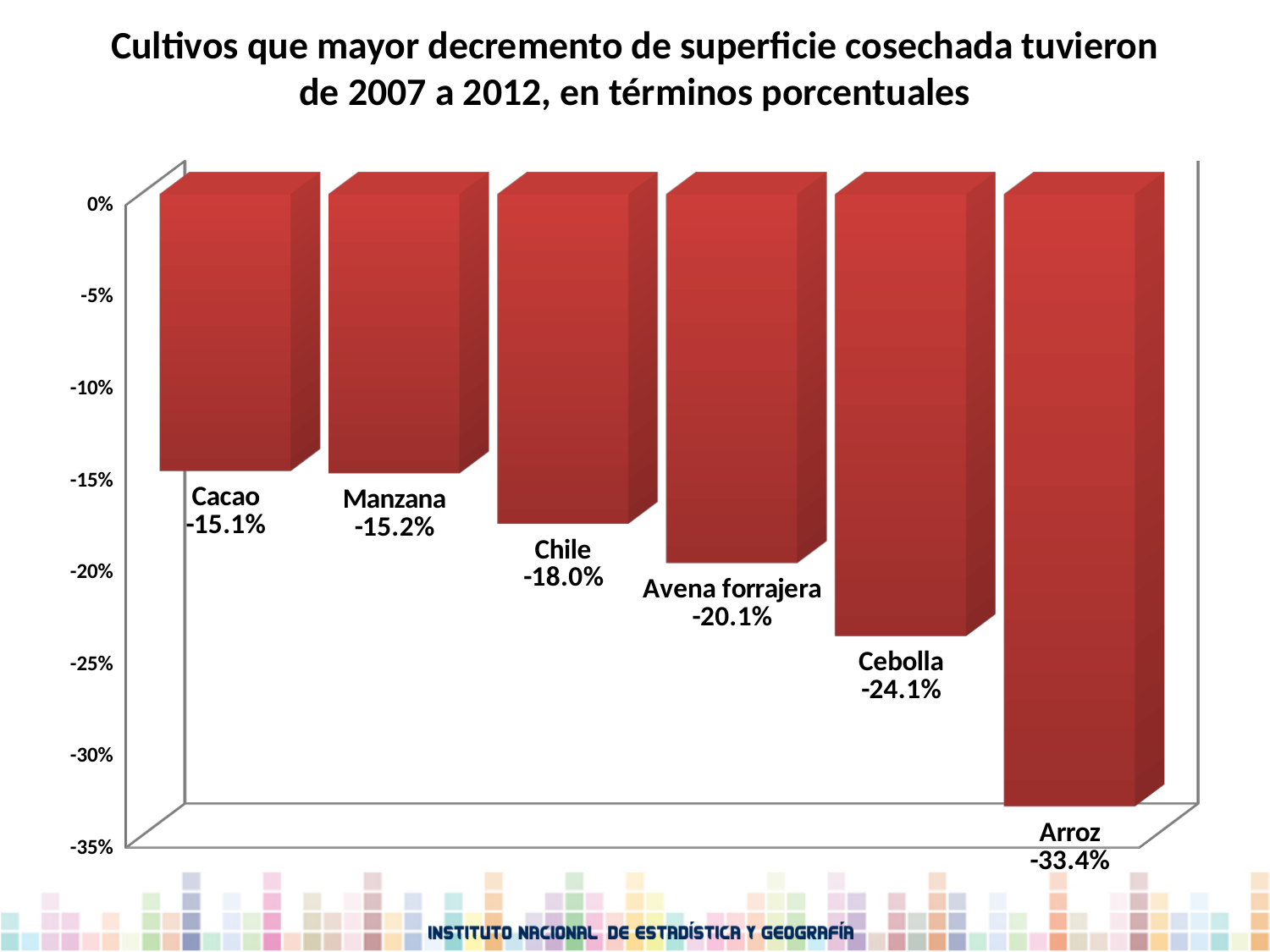
Is the value for Cebolla greater or less than -20%? less Do the values rise or fall moving from left to right across the chart? Fall How many crops are shown in the chart? 6 Which crop has the lowest (most negative) value? Arroz What is the difference in percentage points between the values for Arroz and Cebolla? 9.3 percentage points What is the value for Chile? -18.0% Which has a larger decrease, Chile or Avena forrajera? Avena forrajera What is the value for Cebolla? -24.1% What is the value for Arroz? -33.4% What is the value for Avena forrajera? -20.1% Which crop shows the largest percentage decrease in harvested area? Arroz What kind of chart is shown on the slide? Bar chart